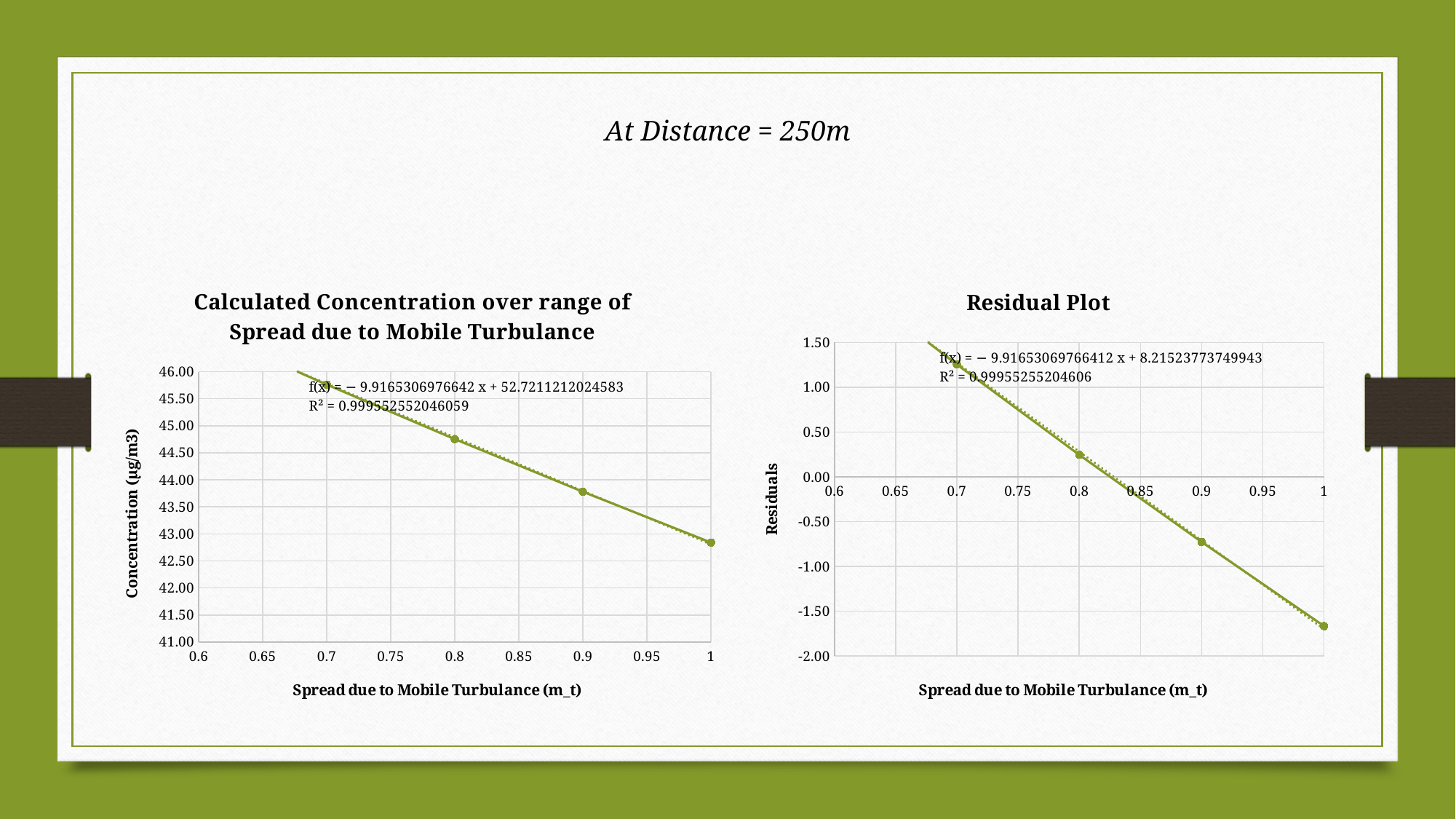
In the Calculated Concentration chart, is the concentration at a spread of 1 greater or less than 43.00? less In the Calculated Concentration chart, which is larger: the concentration at a spread of 0.8 or at a spread of 0.9? 0.8 In the Residual Plot chart, which spread value has the lowest residual? 1 In the Calculated Concentration chart, does the concentration rise or fall as the spread due to mobile turbulance increases? fall In the Residual Plot chart, do the residual values rise or fall as the spread due to mobile turbulance increases along the x axis? fall In the Residual Plot chart, is the residual at a spread of 0.7 greater or less than 1.00? greater In the Calculated Concentration chart, is the concentration at a spread of 0.8 greater or less than 44.50? greater What is the title of the chart on the right of the slide? Residual Plot What is the title of the chart on the left of the slide? Calculated Concentration over range of Spread due to Mobile Turbulance